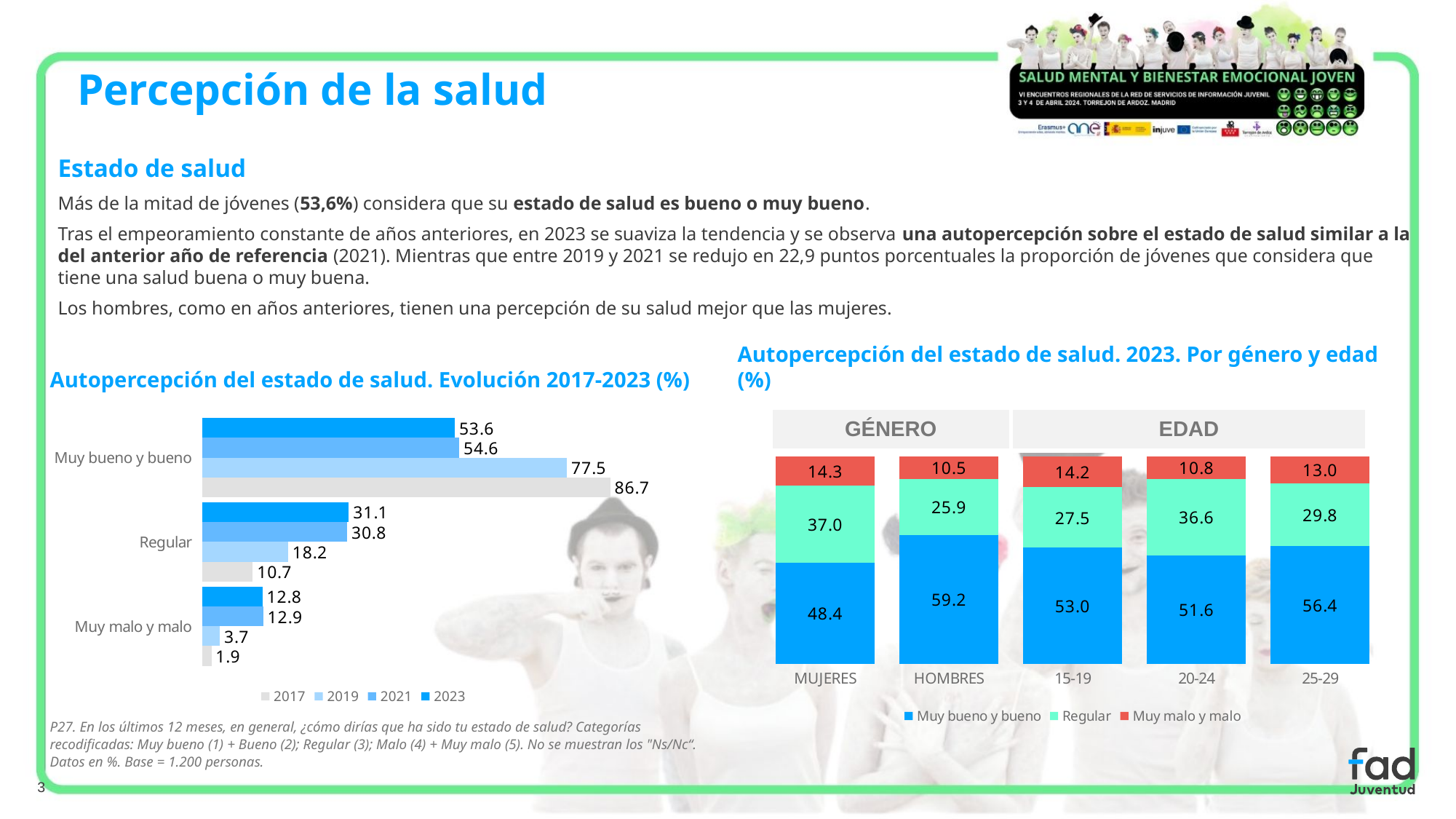
In the chart 'Autopercepción del estado de salud. 2023. Por género y edad (%)', which category has the highest 'Muy malo y malo' value? MUJERES In the chart 'Autopercepción del estado de salud. 2023. Por género y edad (%)', what is the 'Muy bueno y bueno' value for HOMBRES? 59.2 In the chart 'Autopercepción del estado de salud. Evolución 2017-2023 (%)', what is the value for 'Muy bueno y bueno' in 2017? 86.7 In the chart 'Autopercepción del estado de salud. 2023. Por género y edad (%)', what is the 'Regular' value for the 20-24 group? 36.6 In the chart 'Autopercepción del estado de salud. Evolución 2017-2023 (%)', which year has the lowest value for 'Muy malo y malo'? 2017 In the chart 'Autopercepción del estado de salud. Evolución 2017-2023 (%)', how many series does the legend list? 4 In the chart 'Autopercepción del estado de salud. Evolución 2017-2023 (%)', what kind of chart is it? Bar chart In the chart 'Autopercepción del estado de salud. 2023. Por género y edad (%)', how many categories are shown on the x axis? 5 In the chart 'Autopercepción del estado de salud. Evolución 2017-2023 (%)', what is the value for 'Regular' in 2023? 31.1 In the chart 'Autopercepción del estado de salud. Evolución 2017-2023 (%)', what is the difference between the 2019 and 2021 values for 'Muy bueno y bueno'? 22.9 In the chart 'Autopercepción del estado de salud. 2023. Por género y edad (%)', what is the difference between the 'Muy bueno y bueno' values for the 25-29 and 20-24 groups? 4.8 In the chart 'Autopercepción del estado de salud. 2023. Por género y edad (%)', is the 'Muy bueno y bueno' value larger for MUJERES or for HOMBRES? HOMBRES